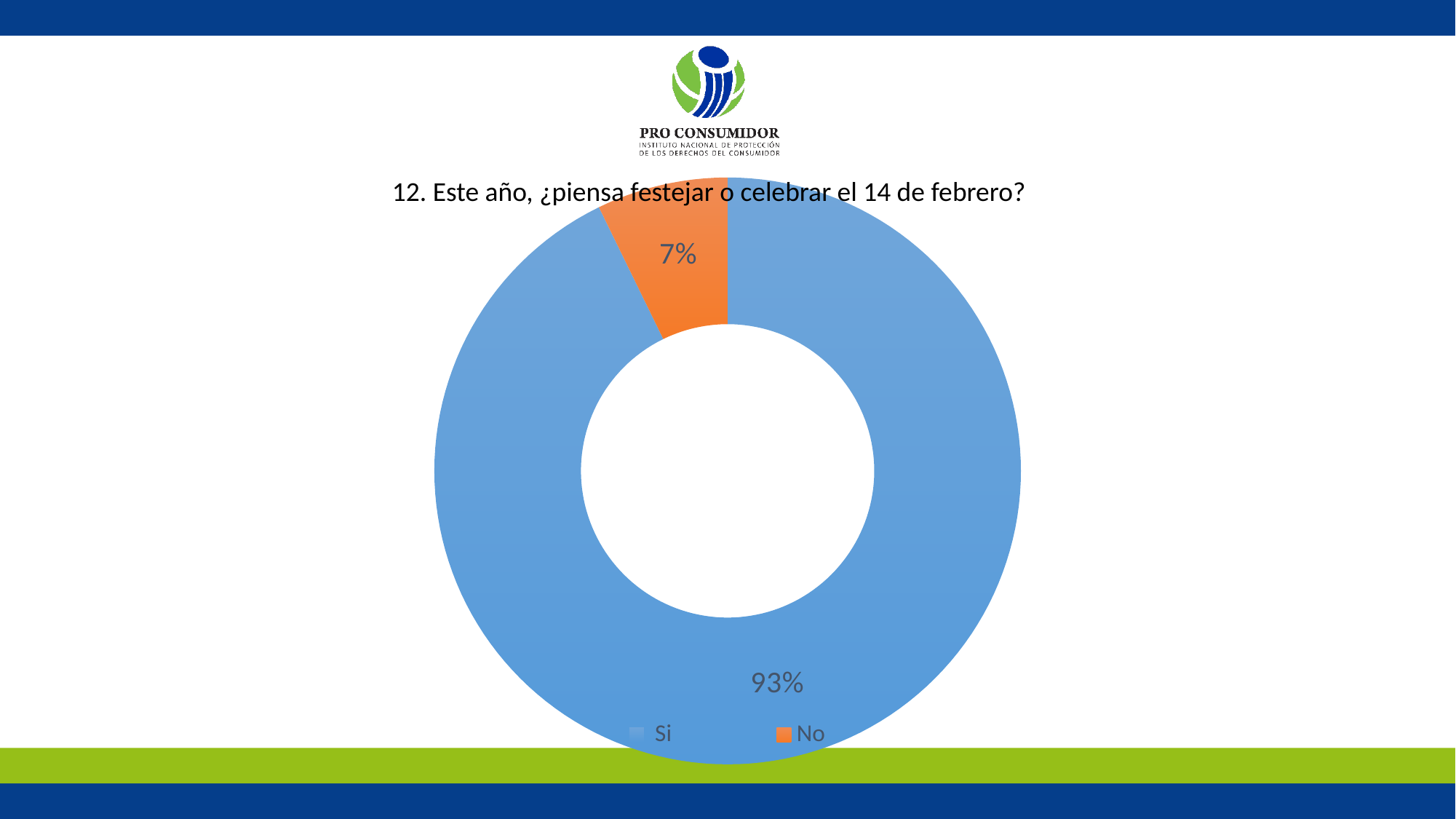
What is the difference in percentage points between 'Si' and 'No'? 86 How many entries does the legend list? 2 What is the title of the chart? 12. Este año, ¿piensa festejar o celebrar el 14 de febrero? What colour represents the 'No' category? Orange What percentage of respondents answered 'Si'? 93% Which is larger, the share for 'Si' or the share for 'No'? Si What percentage of respondents answered 'No'? 7% Which category has the smallest share of the chart? No What kind of chart is shown on the slide? Doughnut chart How many categories does the chart show? 2 Which category has the largest share of the chart? Si